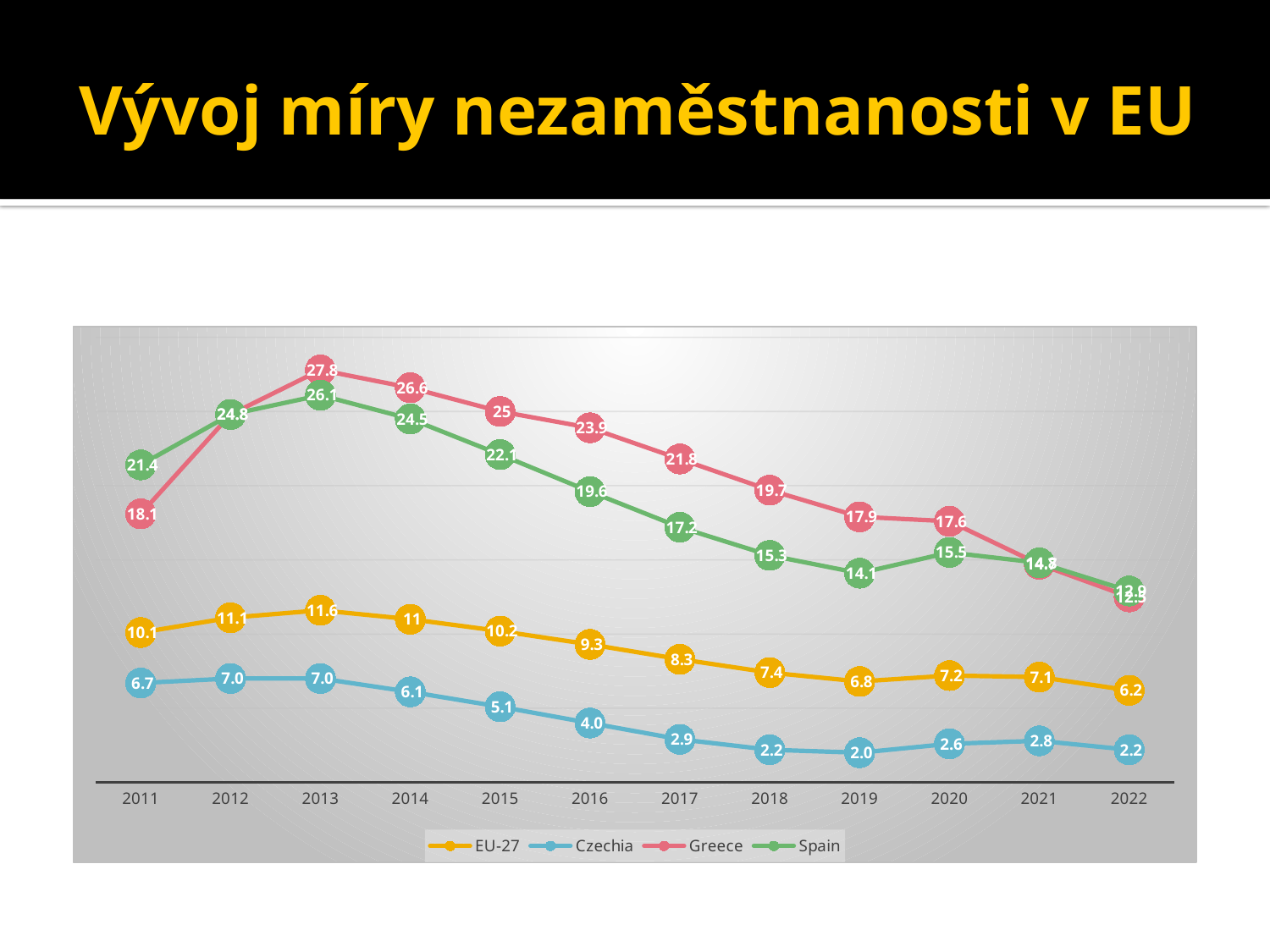
What is the value for Czechia in 2019? 2.0 How many years are shown on the x axis? 12 What type of chart is shown on the slide? line chart How many series does the legend list? 4 In which year does the Czechia series reach its lowest value? 2019 What is the value for Spain in 2018? 15.3 Which is larger in 2015, the value for Greece or the value for Spain? Greece In which year does the Greece series reach its highest value? 2013 Does the EU-27 series rise or fall from 2013 to 2022? fall What is the value for Greece in 2013? 27.8 What is the value for EU-27 in 2016? 9.3 What is the difference between the EU-27 values in 2013 and 2022? 5.4